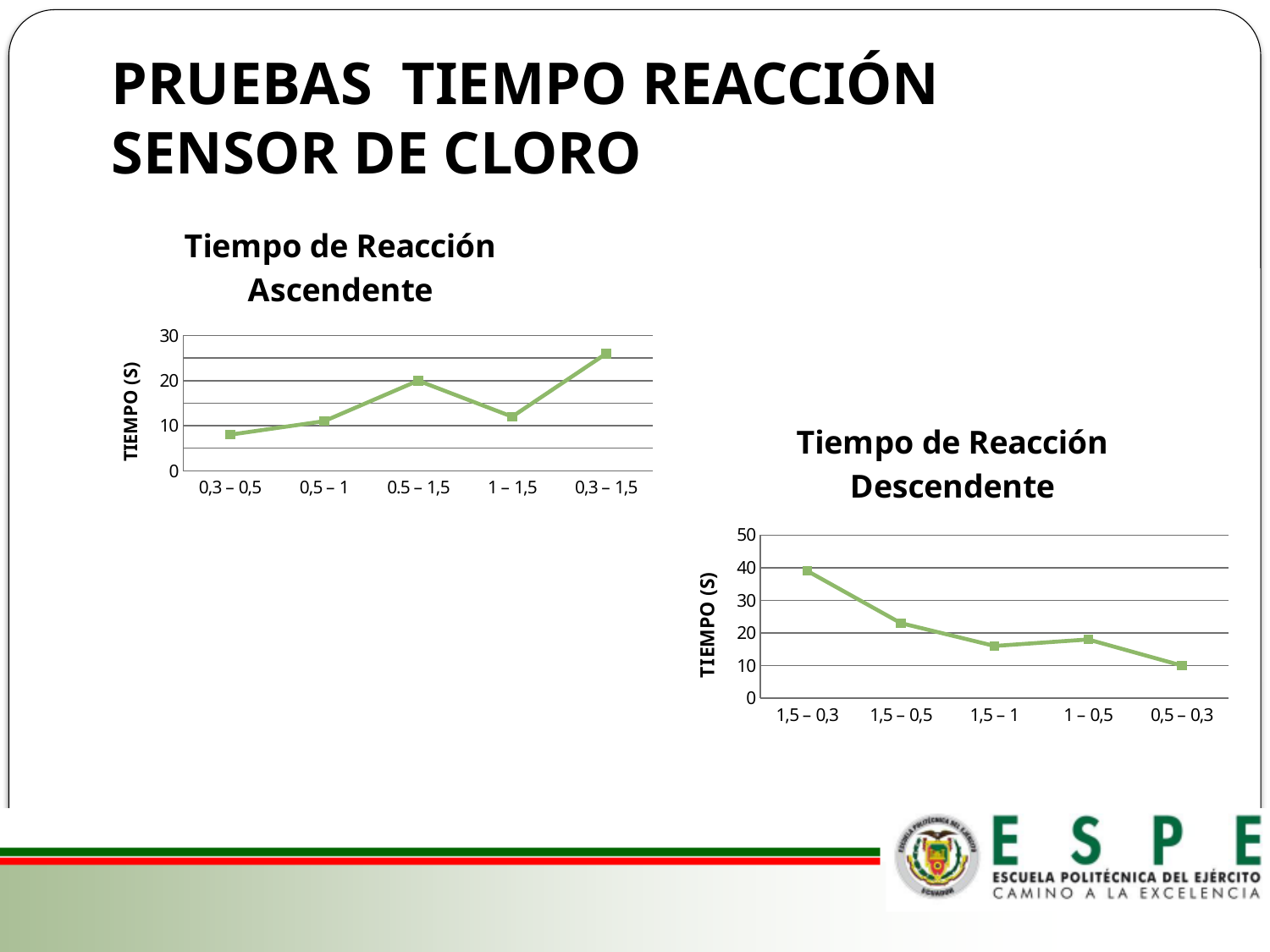
What kind of chart is the 'Tiempo de Reacción Ascendente' chart? line chart In the 'Tiempo de Reacción Ascendente' chart, is the value for 0,3 – 0,5 greater or less than 10? less In the 'Tiempo de Reacción Descendente' chart, is the value for 1,5 – 0,3 greater or less than 30? greater In the 'Tiempo de Reacción Descendente' chart, which category has the lowest value? 0,5 – 0,3 In the 'Tiempo de Reacción Ascendente' chart, which category has the lowest value? 0,3 – 0,5 In the 'Tiempo de Reacción Descendente' chart, how many data points are plotted? 5 In the 'Tiempo de Reacción Descendente' chart, which category has the highest value? 1,5 – 0,3 In the 'Tiempo de Reacción Ascendente' chart, which is larger, the value for 0.5 – 1,5 or the value for 1 – 1,5? 0.5 – 1,5 In the 'Tiempo de Reacción Ascendente' chart, how many categories are shown on the x axis? 5 In the 'Tiempo de Reacción Ascendente' chart, which category has the highest value? 0,3 – 1,5 What kind of chart is the 'Tiempo de Reacción Descendente' chart? line chart What is the label of the vertical axis in the 'Tiempo de Reacción Descendente' chart? TIEMPO (S)